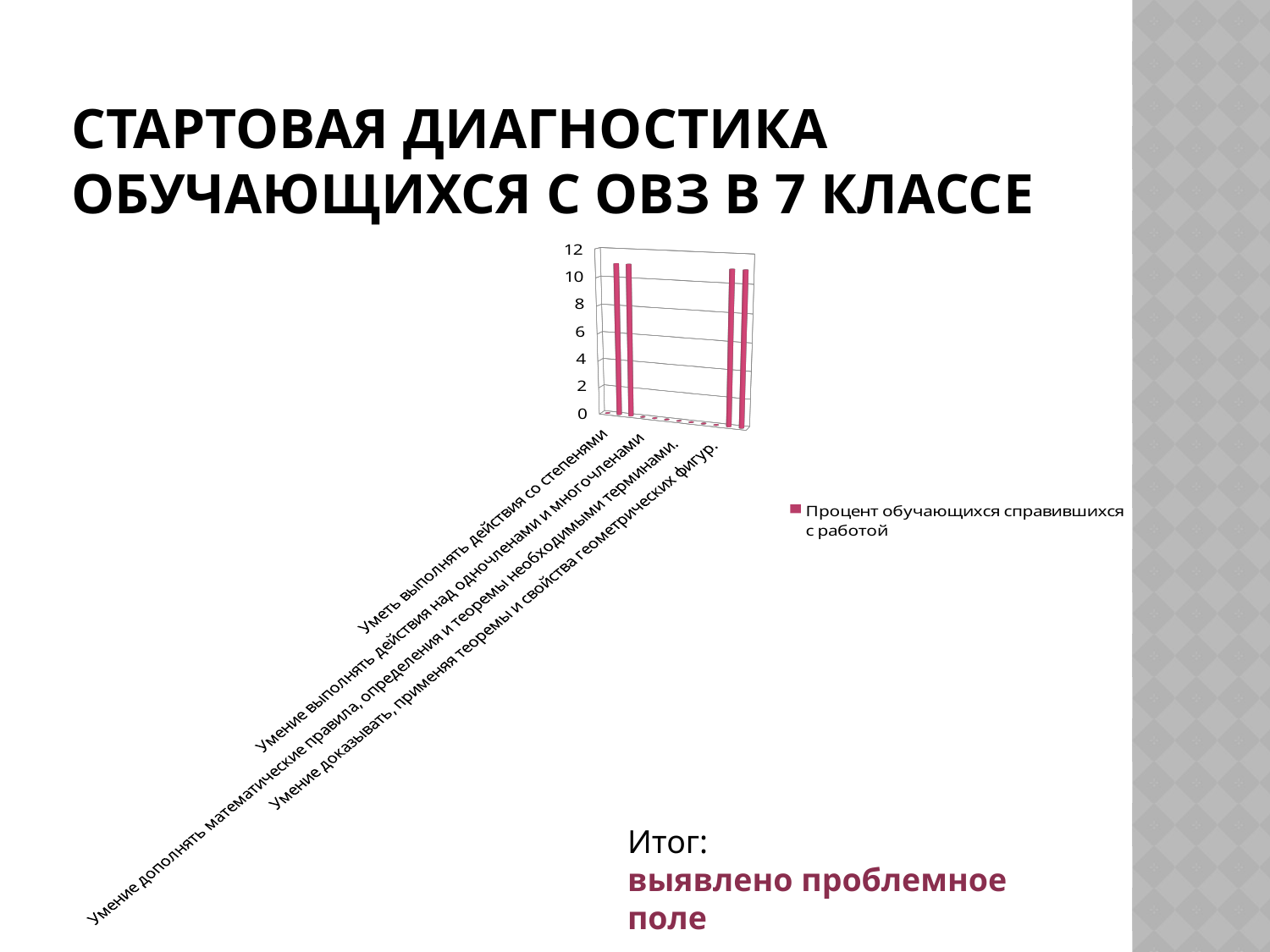
How many bars are visible in the chart? 4 Is the value of the tallest bar in the chart greater or less than 8? greater How many series does the chart legend list? 1 What is the name of the series shown in the chart legend? Процент обучающихся справившихся с работой Is the value of the shortest visible bar in the chart greater or less than 6? greater What is the highest value shown on the chart's vertical axis? 12 What kind of chart is shown on the slide? bar chart Are any of the visible bars in the chart greater than 12? no